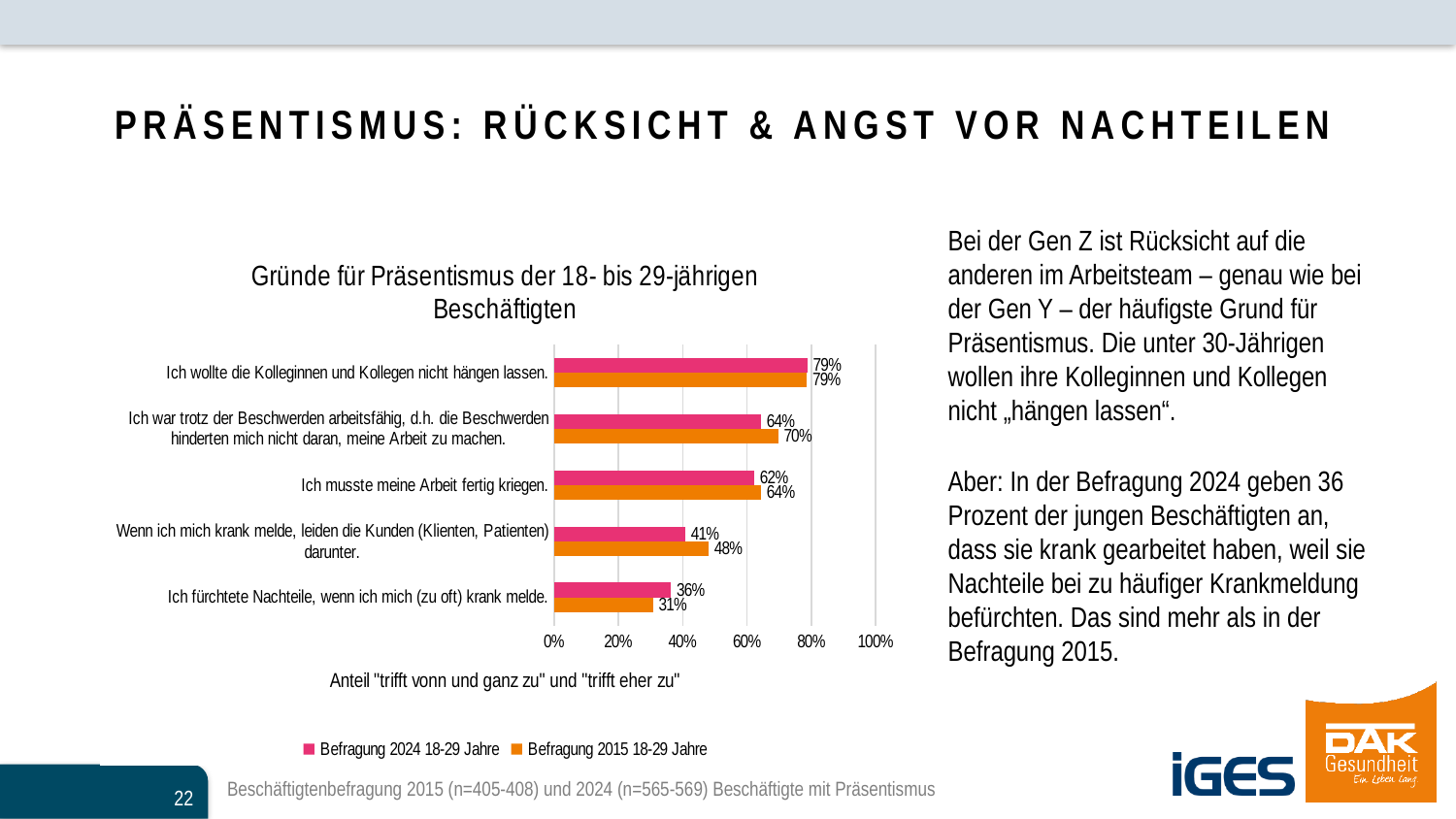
How many reasons (categories) are shown in the chart? 5 What is the 2015 value for "Ich war trotz der Beschwerden arbeitsfähig, d.h. die Beschwerden hinderten mich nicht daran, meine Arbeit zu machen."? 70% Which reason has the lowest value in the Befragung 2015 18-29 Jahre series? Ich fürchtete Nachteile, wenn ich mich (zu oft) krank melde. Which reason has the highest value in the Befragung 2024 18-29 Jahre series? Ich wollte die Kolleginnen und Kollegen nicht hängen lassen. What is the difference between the 2015 and 2024 values for "Wenn ich mich krank melde, leiden die Kunden (Klienten, Patienten) darunter."? 7% How many series does the legend list? 2 What is the 2024 value for "Ich fürchtete Nachteile, wenn ich mich (zu oft) krank melde."? 36% What is the title of the chart? Gründe für Präsentismus der 18- bis 29-jährigen Beschäftigten What type of chart is shown on the slide? bar chart What is the 2024 value for "Wenn ich mich krank melde, leiden die Kunden (Klienten, Patienten) darunter."? 41% For "Ich fürchtete Nachteile, wenn ich mich (zu oft) krank melde.", which survey shows the larger value, 2024 or 2015? Befragung 2024 18-29 Jahre Is the 2024 value for "Ich musste meine Arbeit fertig kriegen." greater or less than 60%? greater